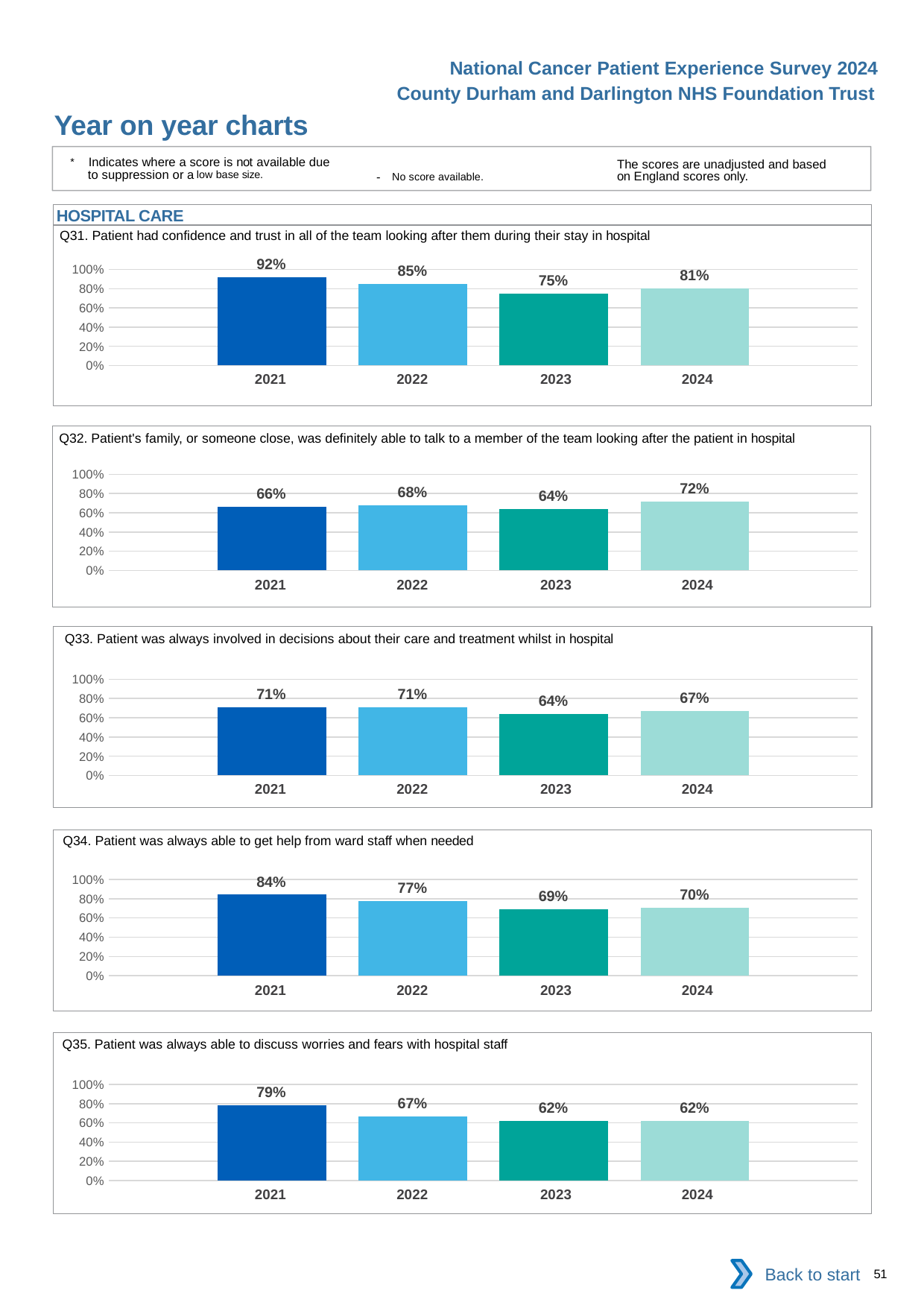
In the Q35 chart, how many years are shown on the x axis? 4 In the Q34 chart, what is the value for 2022? 77% In the Q34 chart, what is the difference between the 2021 and 2024 values? 14 percentage points In the Q33 chart, which is larger, the value for 2023 or the value for 2024? 2024 In the Q31 chart, what is the value for 2021? 92% In the Q31 chart, which year has the lowest value? 2023 In the Q32 chart, which year has the highest value? 2024 What kind of chart is used for Q34? bar chart In the Q35 chart, do the values generally rise or fall from 2021 to 2024? fall In the Q33 chart, what is the difference between the 2021 and 2023 values? 7 percentage points In the Q32 chart, what is the value for 2024? 72% In the Q31 chart, is the value for 2024 greater or less than 80%? greater